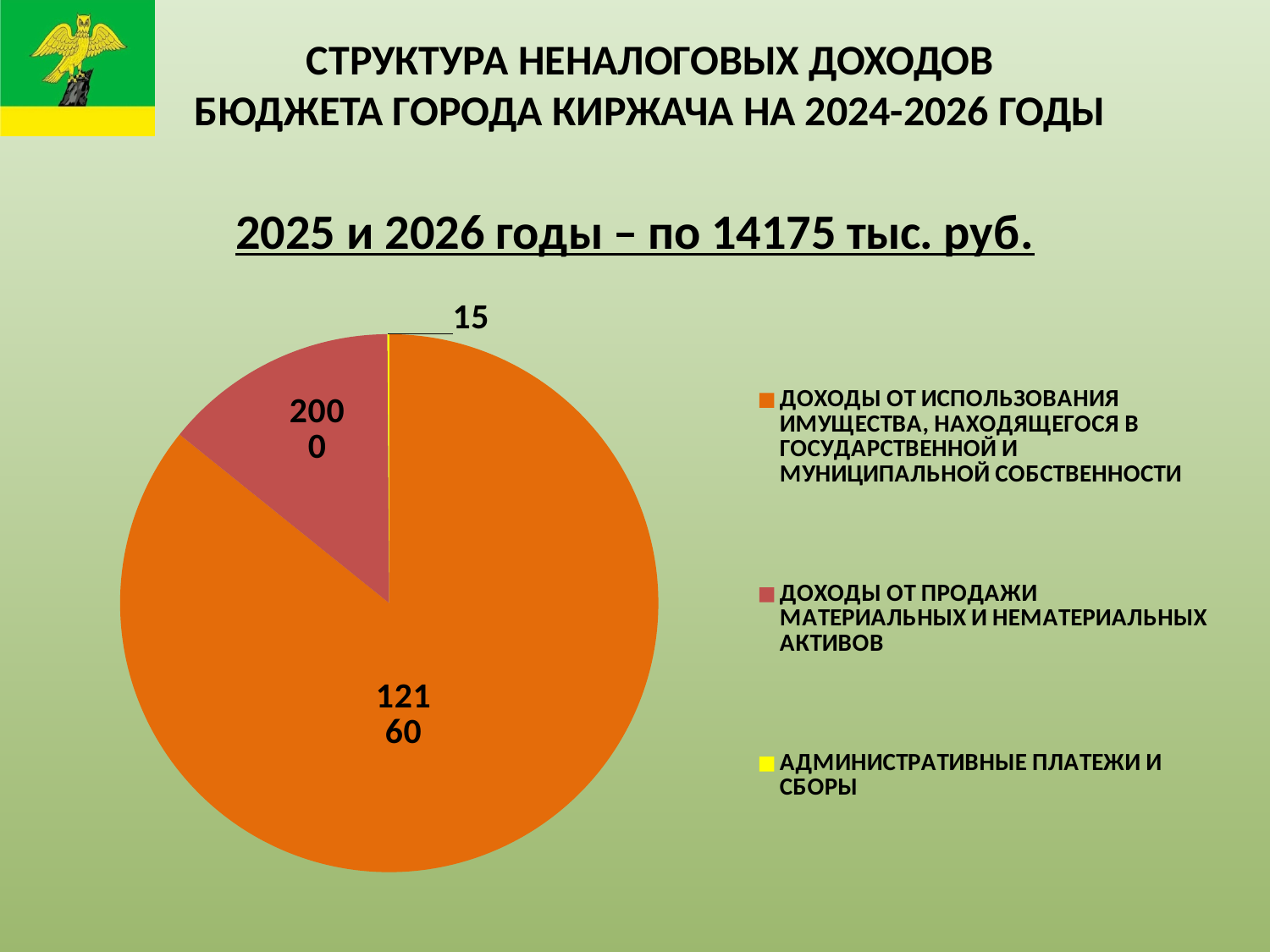
What is the value for ДОХОДЫ ОТ ИСПОЛЬЗОВАНИЯ ИМУЩЕСТВА, НАХОДЯЩЕГОСЯ В ГОСУДАРСТВЕННОЙ И МУНИЦИПАЛЬНОЙ СОБСТВЕННОСТИ? 12160 What is the value for АДМИНИСТРАТИВНЫЕ ПЛАТЕЖИ И СБОРЫ? 15 What is the value for ДОХОДЫ ОТ ПРОДАЖИ МАТЕРИАЛЬНЫХ И НЕМАТЕРИАЛЬНЫХ АКТИВОВ? 2000 What is the difference between the value for ДОХОДЫ ОТ ИСПОЛЬЗОВАНИЯ ИМУЩЕСТВА and the value for ДОХОДЫ ОТ ПРОДАЖИ МАТЕРИАЛЬНЫХ И НЕМАТЕРИАЛЬНЫХ АКТИВОВ? 10160 What total amount in thousand rubles does the subtitle give for 2025 and 2026? 14175 тыс. руб. What colour is the slice for АДМИНИСТРАТИВНЫЕ ПЛАТЕЖИ И СБОРЫ? yellow Which category has the largest slice of the pie? ДОХОДЫ ОТ ИСПОЛЬЗОВАНИЯ ИМУЩЕСТВА, НАХОДЯЩЕГОСЯ В ГОСУДАРСТВЕННОЙ И МУНИЦИПАЛЬНОЙ СОБСТВЕННОСТИ Which category has the smallest slice of the pie? АДМИНИСТРАТИВНЫЕ ПЛАТЕЖИ И СБОРЫ Which is larger: the value for ДОХОДЫ ОТ ПРОДАЖИ МАТЕРИАЛЬНЫХ И НЕМАТЕРИАЛЬНЫХ АКТИВОВ or the value for АДМИНИСТРАТИВНЫЕ ПЛАТЕЖИ И СБОРЫ? ДОХОДЫ ОТ ПРОДАЖИ МАТЕРИАЛЬНЫХ И НЕМАТЕРИАЛЬНЫХ АКТИВОВ What type of chart is shown on the slide? pie chart How many entries does the legend list? 3 How many slices does the pie chart have? 3